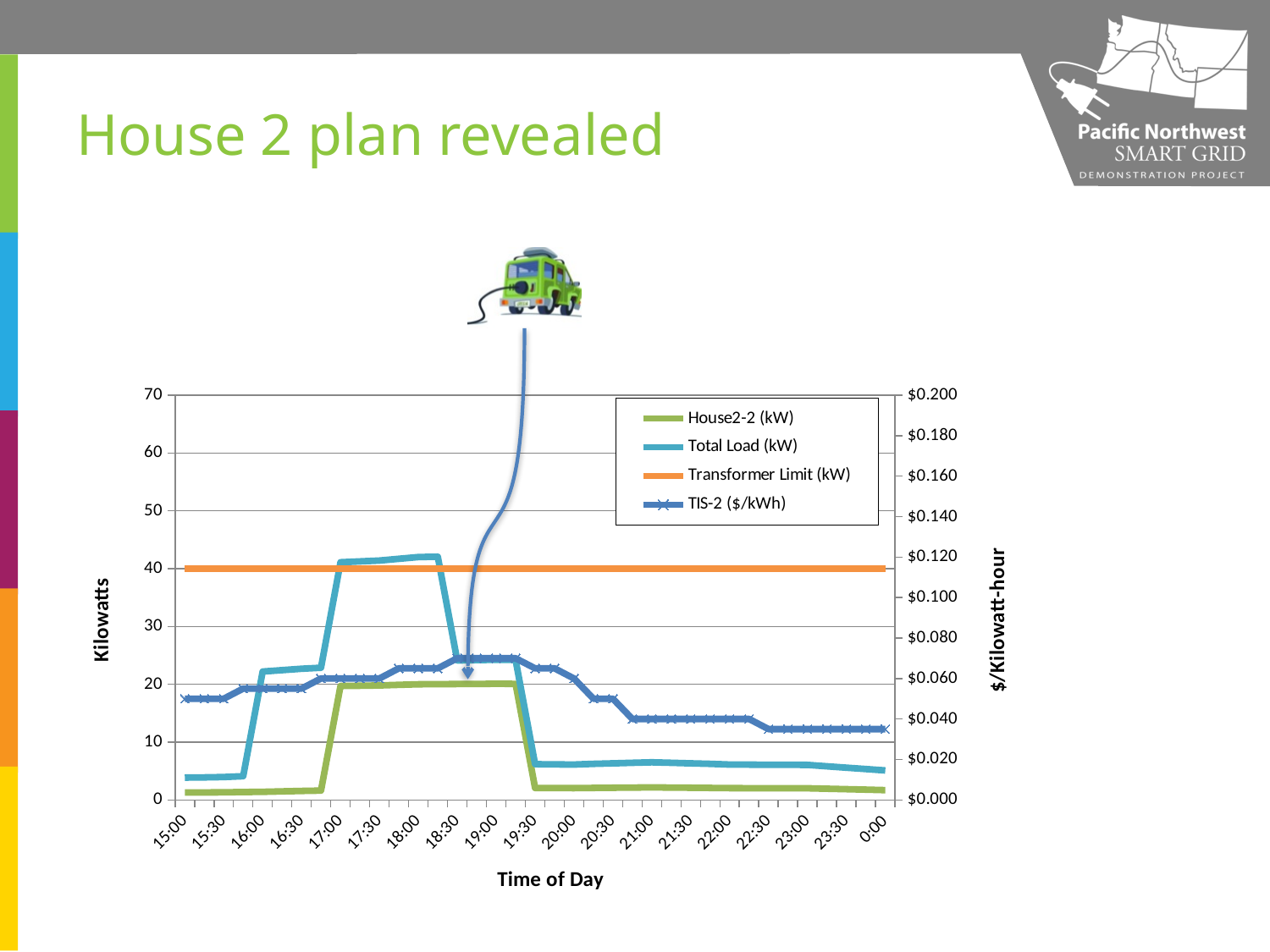
Is the Total Load (kW) value at 22:00 greater or less than 10? less Is the House2-2 (kW) value at 15:00 greater or less than 10? less Is the Total Load (kW) value at 18:00 greater or less than 30? greater At 18:00, which is larger: Total Load (kW) or House2-2 (kW)? Total Load (kW) How many series does the chart legend list? 4 Does the TIS-2 ($/kWh) series rise or fall from 19:00 to 0:00? Fall What is the title of the x axis? Time of Day How many time-of-day ticks are labelled on the x axis? 19 What type of chart is shown on the slide? Line chart What is the value of the Transformer Limit (kW) series? 40